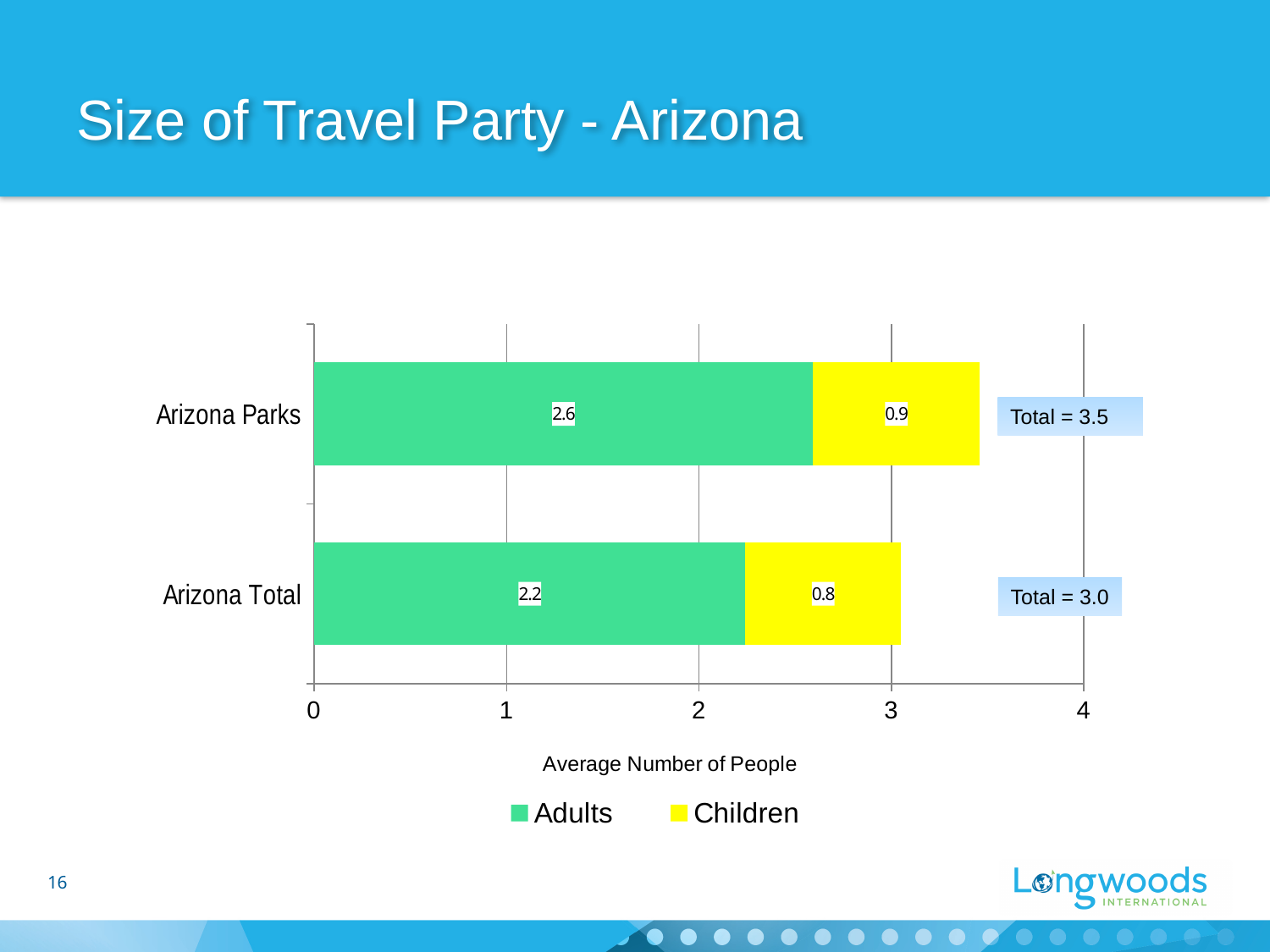
What is the total average travel party size for Arizona Parks? 3.5 What is the average number of adults in the travel party for Arizona Parks? 2.6 What is the difference in the average number of adults between Arizona Parks and Arizona Total? 0.4 What is the average number of children in the travel party for Arizona Total? 0.8 How many categories are shown on the chart? 2 What is the total average travel party size for Arizona Total? 3.0 Which category has the higher average number of adults, Arizona Parks or Arizona Total? Arizona Parks How many series does the legend list? 2 What is the difference in total travel party size between Arizona Parks and Arizona Total? 0.5 What is the label of the horizontal axis? Average Number of People What is the average number of children in the travel party for Arizona Parks? 0.9 What kind of chart is shown on the slide? Stacked bar chart